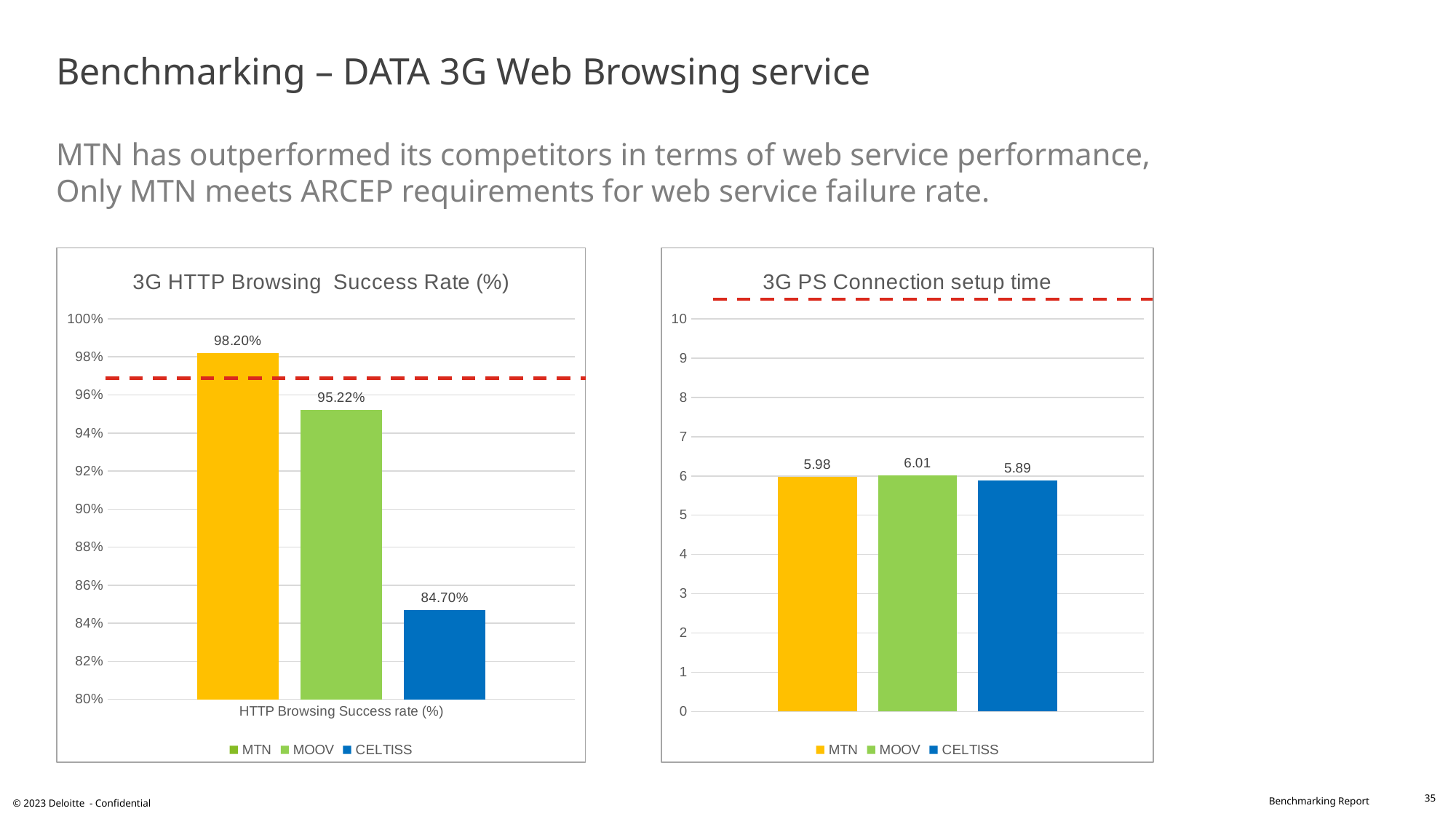
In the 3G HTTP Browsing Success Rate (%) chart, which operator has the lowest success rate? CELTISS What kind of chart is the 3G HTTP Browsing Success Rate (%) chart? Bar chart In the 3G PS Connection setup time chart, which operator has the highest setup time? MOOV In the 3G HTTP Browsing Success Rate (%) chart, what is the difference between MTN and MOOV? 2.98% In the 3G HTTP Browsing Success Rate (%) chart, is the value for MOOV greater or less than 96%? less In the 3G PS Connection setup time chart, what is the difference between MOOV and CELTISS? 0.12 In the 3G PS Connection setup time chart, what is the value for MOOV? 6.01 How many series does the legend of the 3G PS Connection setup time chart list? 3 In the 3G PS Connection setup time chart, which is larger, the value for MTN or the value for CELTISS? MTN In the 3G HTTP Browsing Success Rate (%) chart, what is the value for MTN? 98.20% In the 3G PS Connection setup time chart, what is the value for CELTISS? 5.89 In the 3G HTTP Browsing Success Rate (%) chart, what is the value for CELTISS? 84.70%